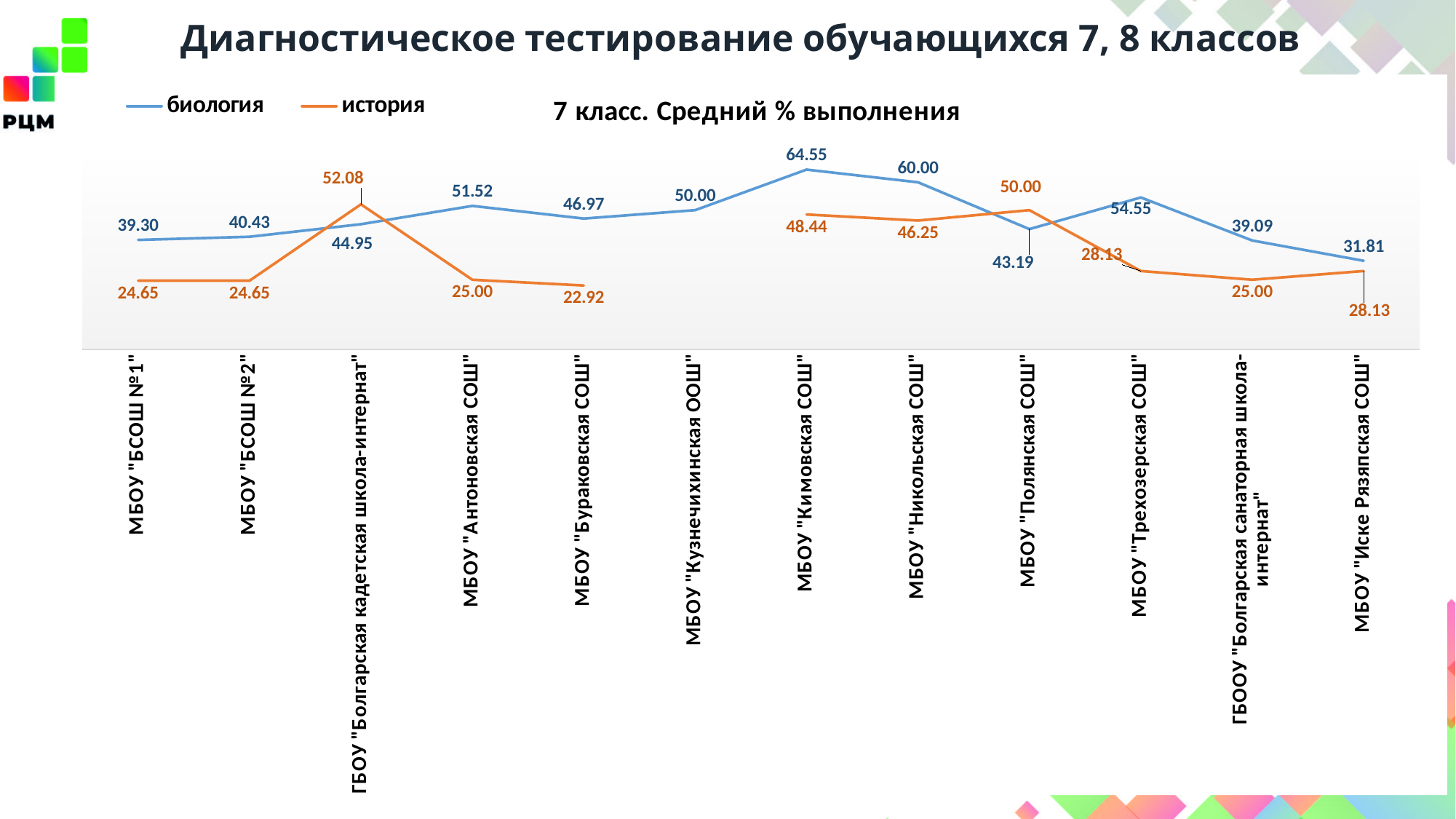
Which school has the lowest история value? МБОУ "Бураковская СОШ" What kind of chart is shown on the slide? line chart What is the биология value for МБОУ "Кимовская СОШ"? 64.55 Which school has the highest биология value? МБОУ "Кимовская СОШ" What is the title of the chart? 7 класс. Средний % выполнения For МБОУ "Полянская СОШ", which series has the larger value, биология or история? история How many schools are shown along the x axis? 12 What is the история value for ГБОУ "Болгарская кадетская школа-интернат"? 52.08 How many series does the legend list? 2 What is the биология value for МБОУ "Полянская СОШ"? 43.19 What is the difference between the биология and история values for МБОУ "Кимовская СОШ"? 16.11 Which school has the lowest биология value? МБОУ "Иске Рязяпская СОШ"